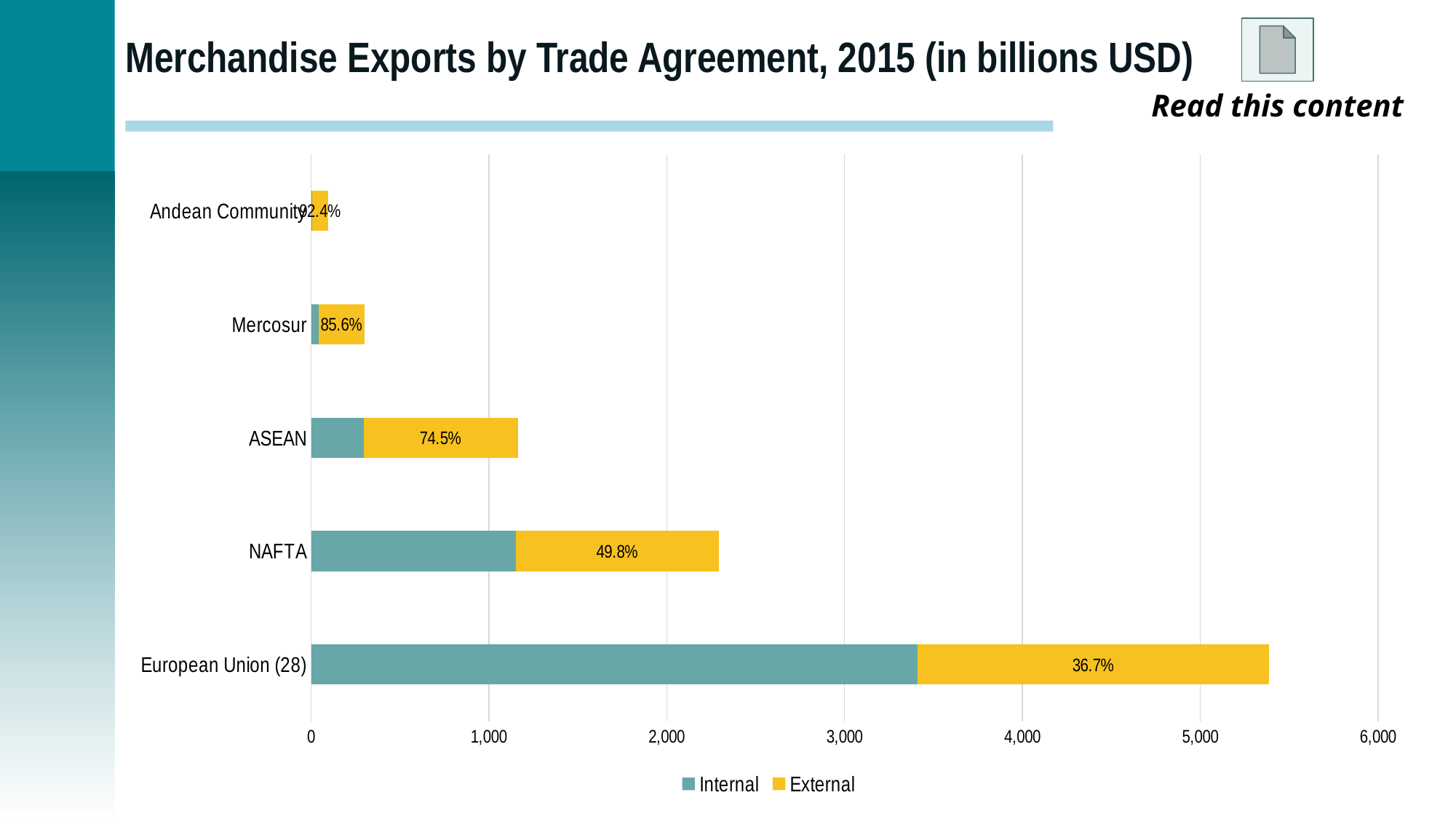
What percentage label is shown on the External segment for ASEAN? 74.5% Which trade agreement has the longest total bar? European Union (28) What percentage label is shown on the External segment for Mercosur? 85.6% Is the total bar for European Union (28) greater or less than 5,000? greater What type of chart is shown on the slide? Stacked bar chart How many series does the legend list? 2 Which series is shown in yellow in the legend? External Is the total bar for NAFTA greater or less than 2,000? greater Which trade agreement has the shortest total bar? Andean Community What percentage label is shown on the External segment for NAFTA? 49.8% What percentage label is shown on the External segment for European Union (28)? 36.7% How many trade agreements are shown on the chart? 5